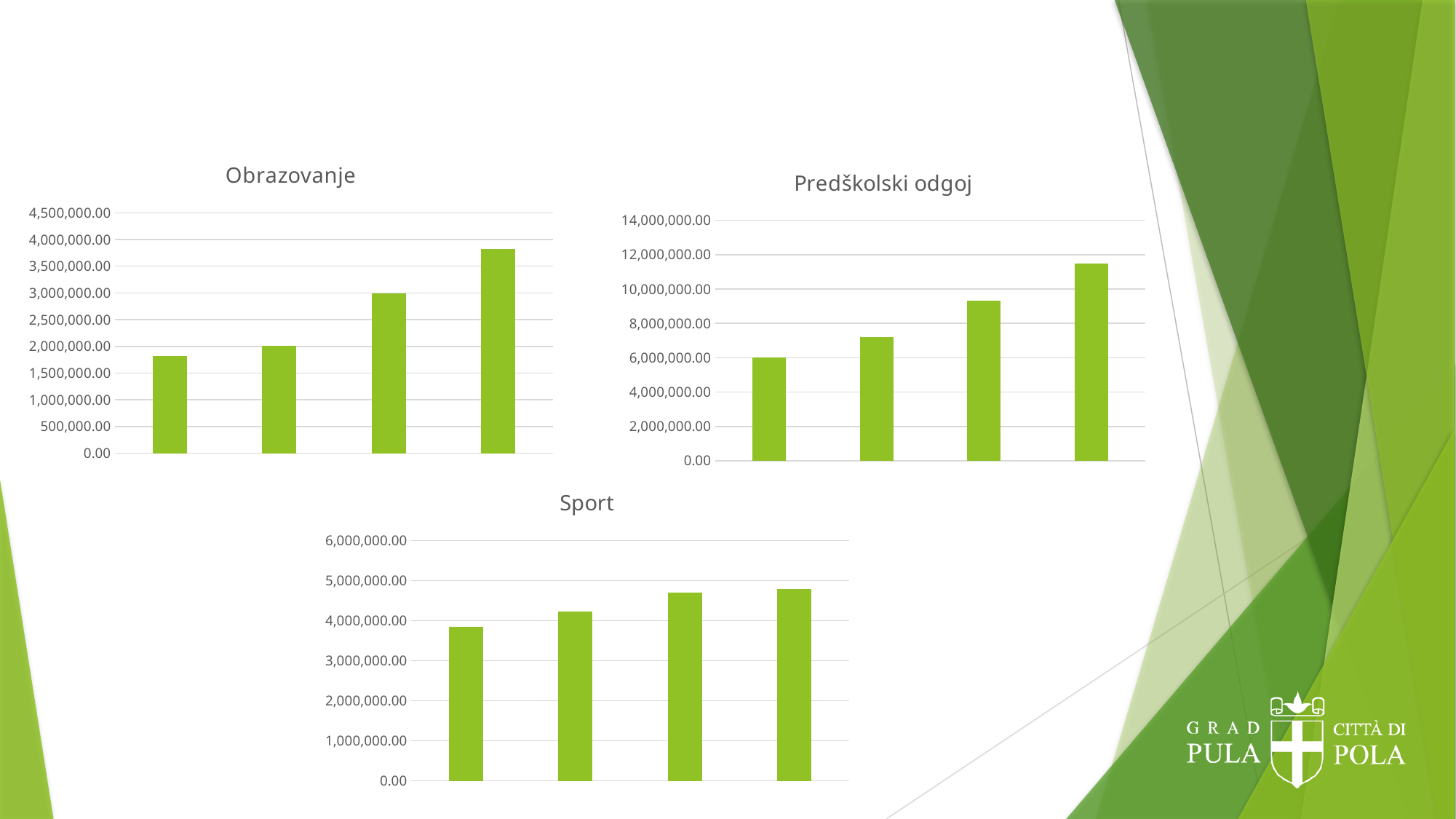
In the "Obrazovanje" chart, is the value of the rightmost bar greater or less than 3,500,000.00? greater In the "Sport" chart, do the bar values rise or fall from left to right? rise How many charts are shown on the slide? 3 In the "Obrazovanje" chart, do the bar values rise or fall from left to right? rise How many bars are plotted in the "Predškolski odgoj" chart? 4 In the "Predškolski odgoj" chart, is the third bar larger or smaller than the second bar? larger What is the highest value shown on the vertical axis of the "Sport" chart? 6,000,000.00 In the "Sport" chart, is the value of the leftmost bar greater or less than 4,000,000.00? less In the "Predškolski odgoj" chart, is the value of the rightmost bar greater or less than 12,000,000.00? less In the "Predškolski odgoj" chart, which bar is the shortest? the first (leftmost) bar What kind of chart is the "Obrazovanje" chart? bar chart In the "Obrazovanje" chart, which bar is the tallest? the fourth (rightmost) bar